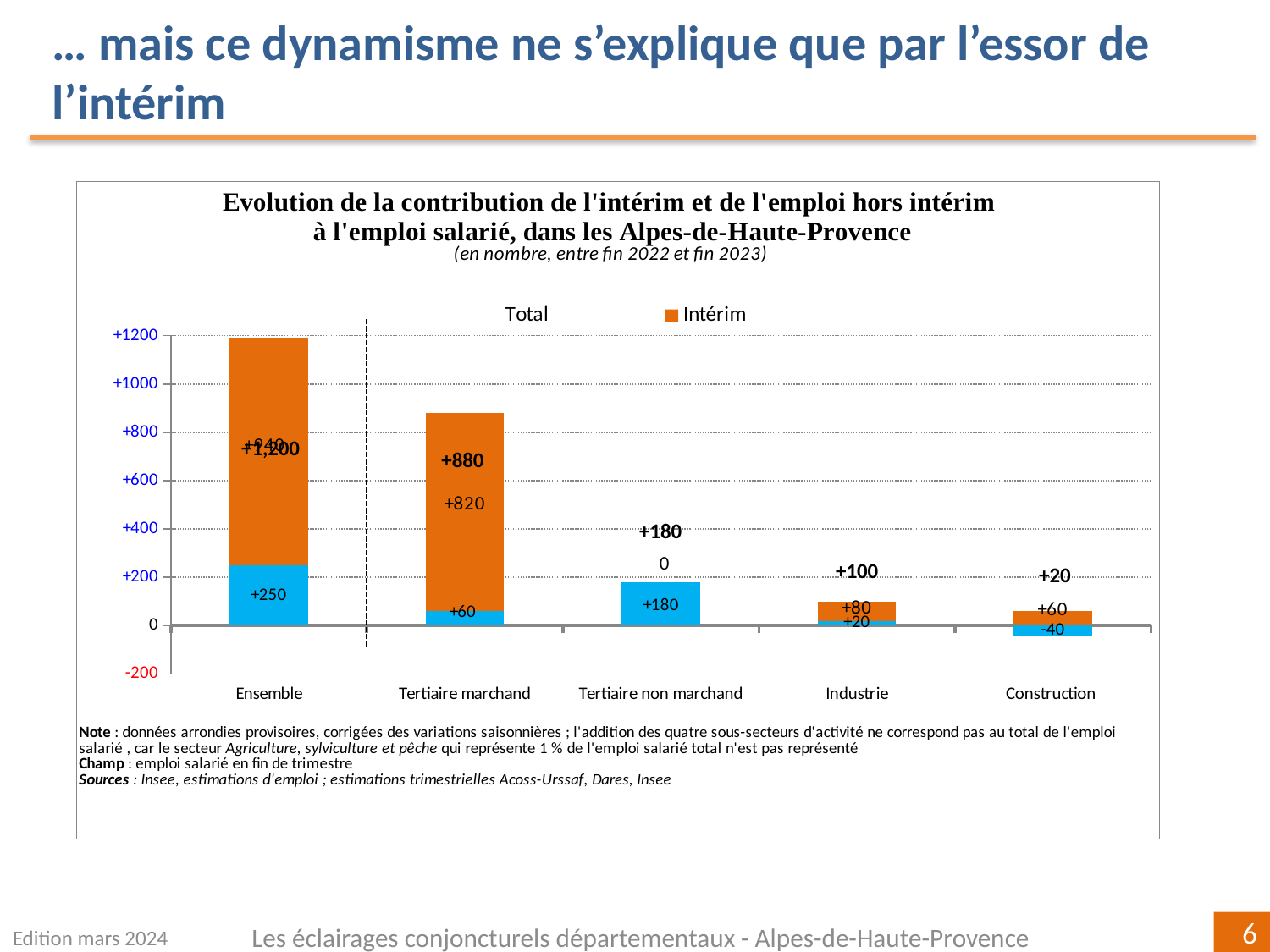
Which category has the lowest total value? Construction What is the total value shown for Industrie? +100 Which category has the highest total value? Ensemble What is the Intérim value for Tertiaire non marchand? 0 How many sector categories are shown on the x axis of the chart? 5 What is the difference between the total for Tertiaire marchand and the total for Industrie? 780 What is the Intérim value for Tertiaire marchand? +820 What is the Intérim value for Construction? +60 Which has the larger Intérim value, Tertiaire marchand or Industrie? Tertiaire marchand What is the value of the blue segment for Tertiaire non marchand? +180 Which colour represents the Intérim series in the chart? orange What kind of chart is shown on the slide? bar chart